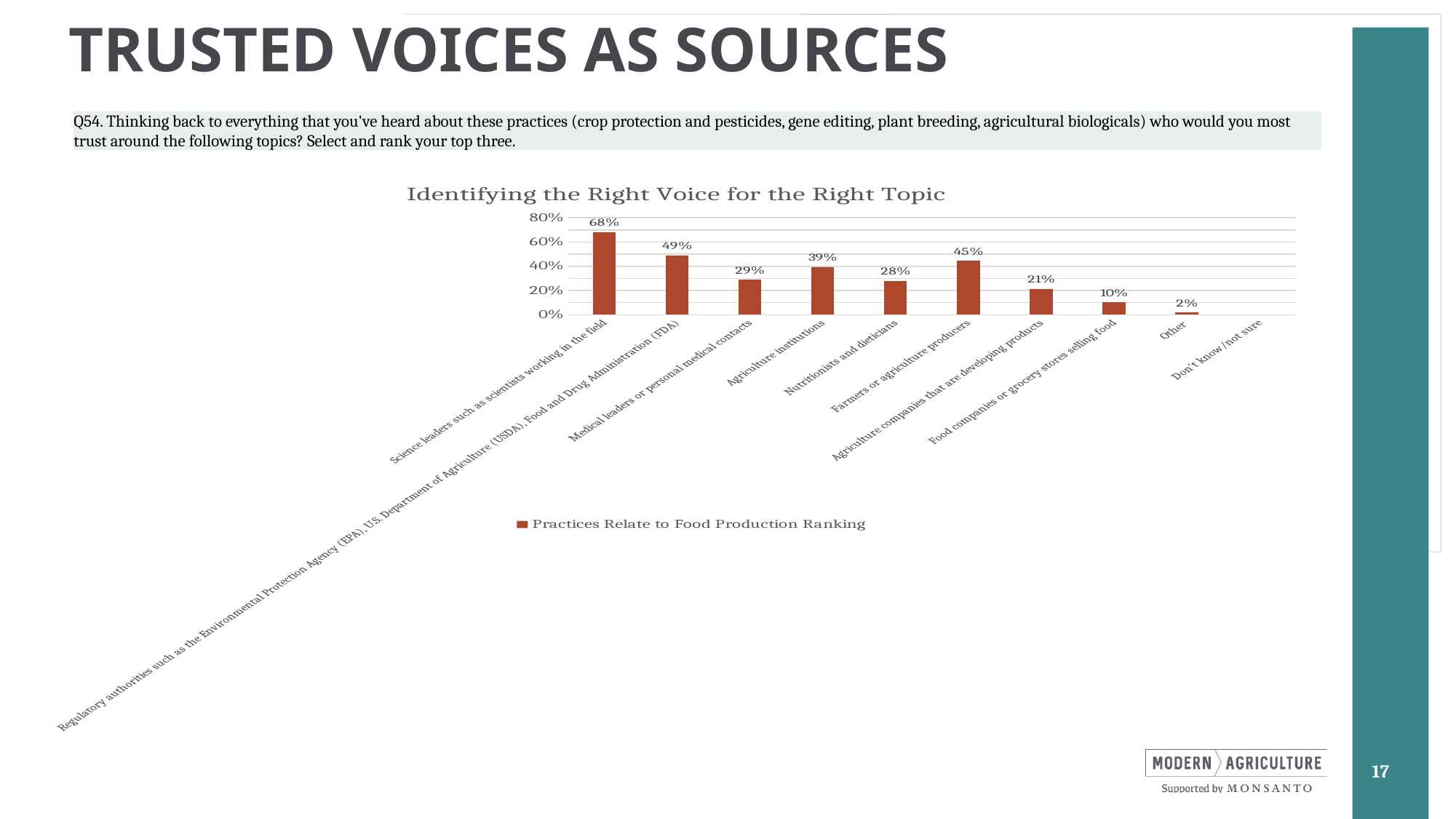
What is the title of the chart? Identifying the Right Voice for the Right Topic What is the difference between the values for Science leaders such as scientists working in the field and Farmers or agriculture producers? 23% What is the value for Farmers or agriculture producers? 45% Which is larger: the value for Nutritionists and dieticians or the value for Agriculture companies that are developing products? Nutritionists and dieticians What is the value for Agriculture institutions? 39% What kind of chart is shown on the slide? Bar chart How many categories are shown on the x axis? 10 What is the value for Food companies or grocery stores selling food? 10% Is the value for Medical leaders or personal medical contacts greater or less than 40%? less What is the value for Science leaders such as scientists working in the field? 68% Which category has the highest value? Science leaders such as scientists working in the field